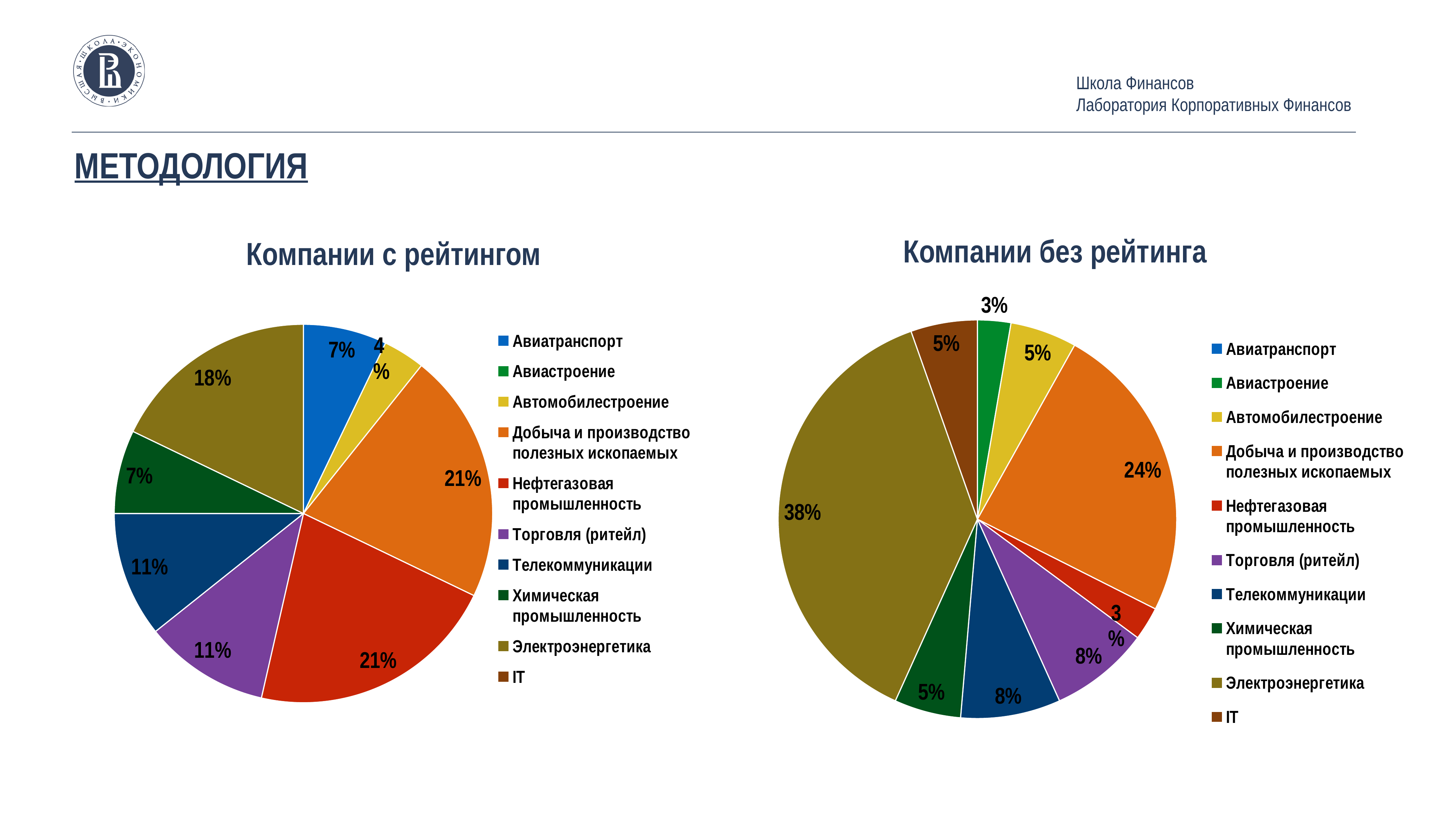
In the "Компании с рейтингом" pie chart, which labelled sector has the smallest slice? Автомобилестроение What type of chart is used for "Компании без рейтинга"? Pie chart How many sectors are listed in the legend of the "Компании с рейтингом" chart? 10 In the "Компании с рейтингом" pie chart, what share does Нефтегазовая промышленность have? 21% In the "Компании с рейтингом" pie chart, what share does Электроэнергетика have? 18% In the "Компании без рейтинга" pie chart, what share does Добыча и производство полезных ископаемых have? 24% In the "Компании без рейтинга" pie chart, what share does IT have? 5% In the "Компании с рейтингом" pie chart, what share does Авиатранспорт have? 7% In the "Компании без рейтинга" pie chart, which sector has the largest slice? Электроэнергетика In the "Компании без рейтинга" pie chart, what share does Электроэнергетика have? 38% In the "Компании с рейтингом" pie chart, which is larger: Телекоммуникации or Химическая промышленность? Телекоммуникации In the "Компании без рейтинга" pie chart, how many percentage points larger is Электроэнергетика than Добыча и производство полезных ископаемых? 14 percentage points